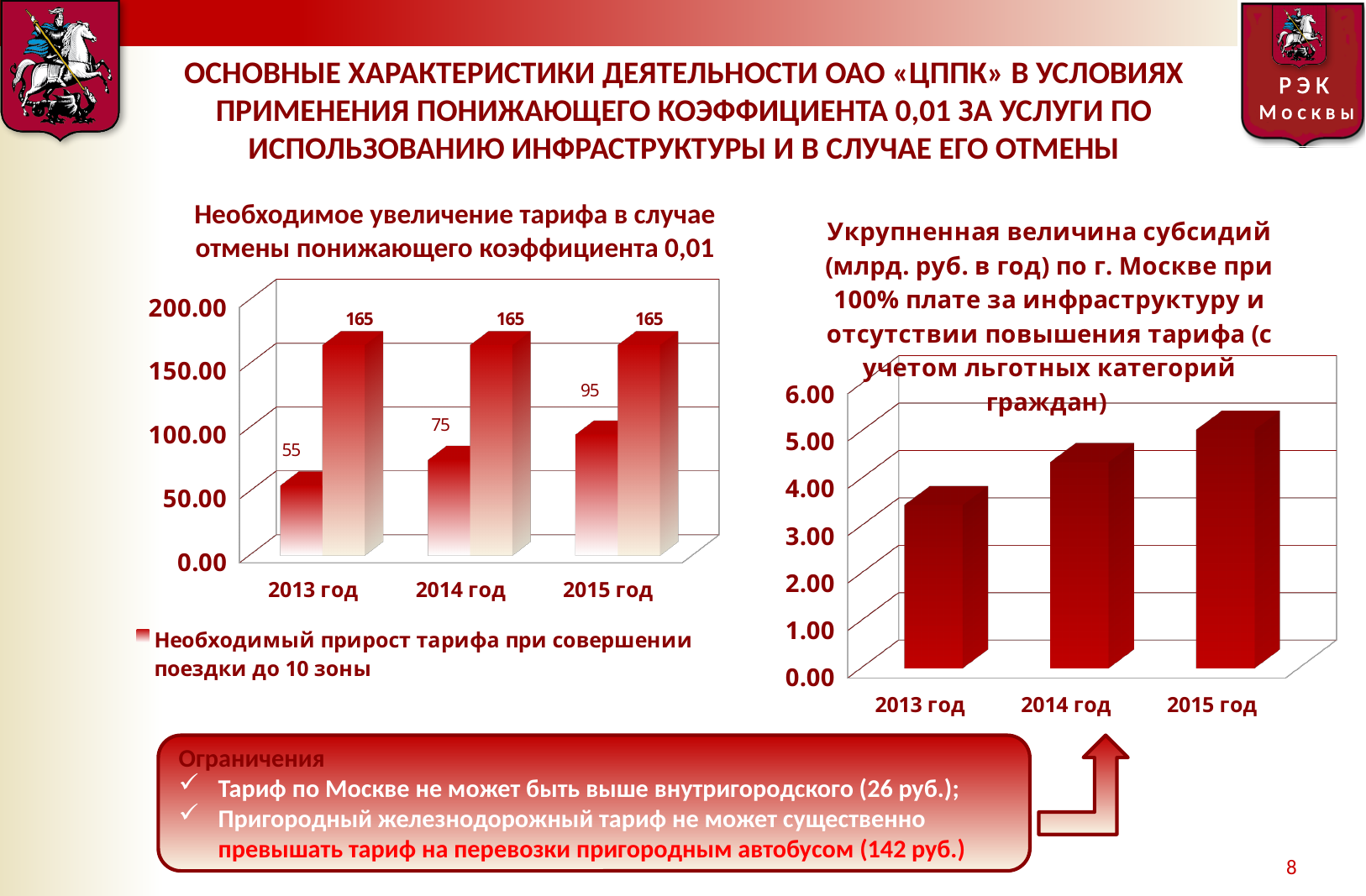
On the left chart (Необходимое увеличение тарифа...), what is the value of the shorter bar for 2013 год? 55 On the left chart (Необходимое увеличение тарифа...), do the values of the shorter bars rise or fall from 2013 год to 2015 год? rise What kind of chart is the right chart (Укрупненная величина субсидий...)? bar chart On the right chart (Укрупненная величина субсидий...), is the value for 2014 год greater or less than 4.00? greater How many year categories are shown on the left chart (Необходимое увеличение тарифа...)? 3 On the left chart (Необходимое увеличение тарифа...), in which year is the shorter bar lowest? 2013 год On the left chart (Необходимое увеличение тарифа...), what is the difference between the two bars for 2013 год? 110 On the left chart (Необходимое увеличение тарифа...), what is the value of the shorter bar for 2015 год? 95 On the left chart (Необходимое увеличение тарифа...), what is the value of the taller bar for 2014 год? 165 On the right chart (Укрупненная величина субсидий...), which year has the highest value? 2015 год On the left chart (Необходимое увеличение тарифа...), what is the difference between the two bars for 2015 год? 70